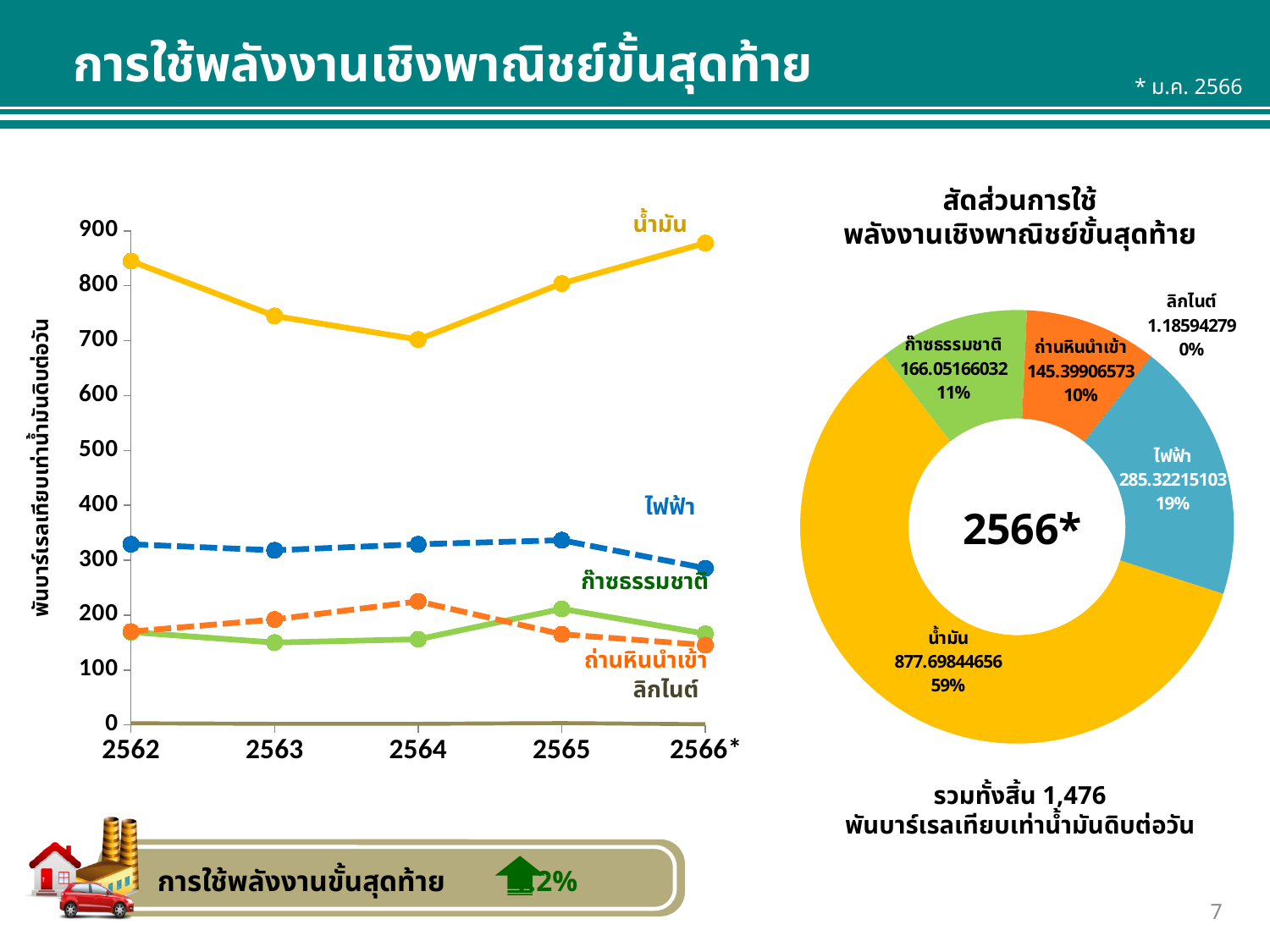
What kind of chart is the chart on the left of the slide? Line chart In the line chart on the left, how many years are shown on the x axis? 5 In the line chart on the left, does the น้ำมัน line rise or fall from 2564 to 2566*? rise In the pie chart on the right, which is larger, ก๊าซธรรมชาติ or ถ่านหินนำเข้า? ก๊าซธรรมชาติ In the pie chart on the right, which category has the smallest slice? ลิกไนต์ In the pie chart on the right, what value is shown for น้ำมัน? 877.69844656 In the pie chart on the right, what share of the total does ก๊าซธรรมชาติ account for? 11% In the pie chart on the right, what share of the total does ไฟฟ้า account for? 19% In the line chart on the left, is the value for น้ำมัน in 2564 greater or less than 800? less How many slices does the pie chart on the right have? 5 In the pie chart on the right, which category has the largest slice? น้ำมัน In the line chart on the left, is the value for ไฟฟ้า in 2566* greater or less than 300? less